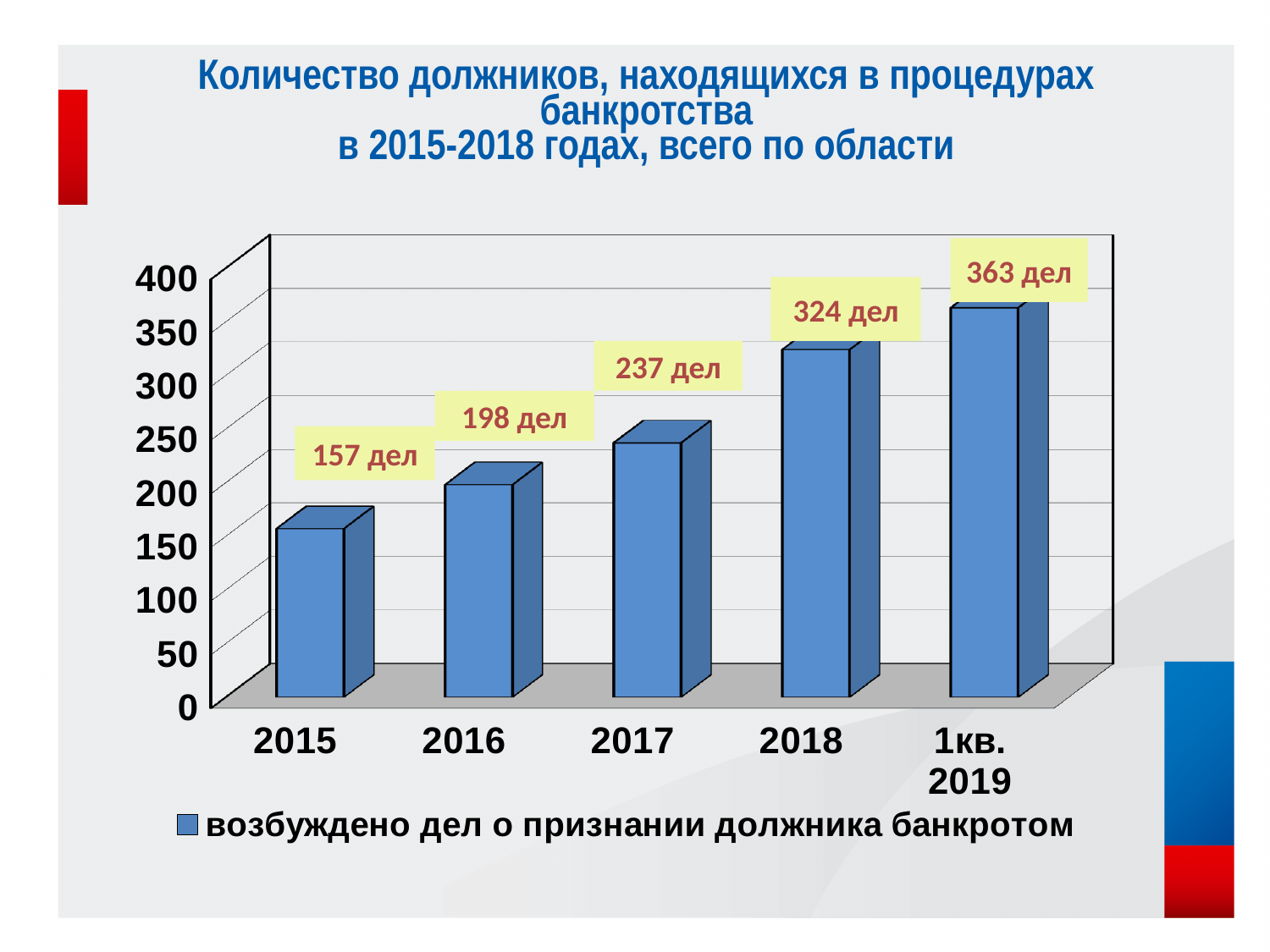
Is the value for 2016 greater or less than 150? greater Do the values rise or fall from 2015 to 1кв. 2019? rise Which is larger, the value for 2016 or the value for 2018? 2018 Which category has the highest value? 1кв. 2019 Which category has the lowest value? 2015 What is the value for 1кв. 2019? 363 дел How many categories are shown on the x axis? 5 What kind of chart is shown? bar chart What is the value for 2017? 237 дел What is the difference between the values for 2018 and 2017? 87 дел What is the value for 2015? 157 дел How many series does the legend list? 1